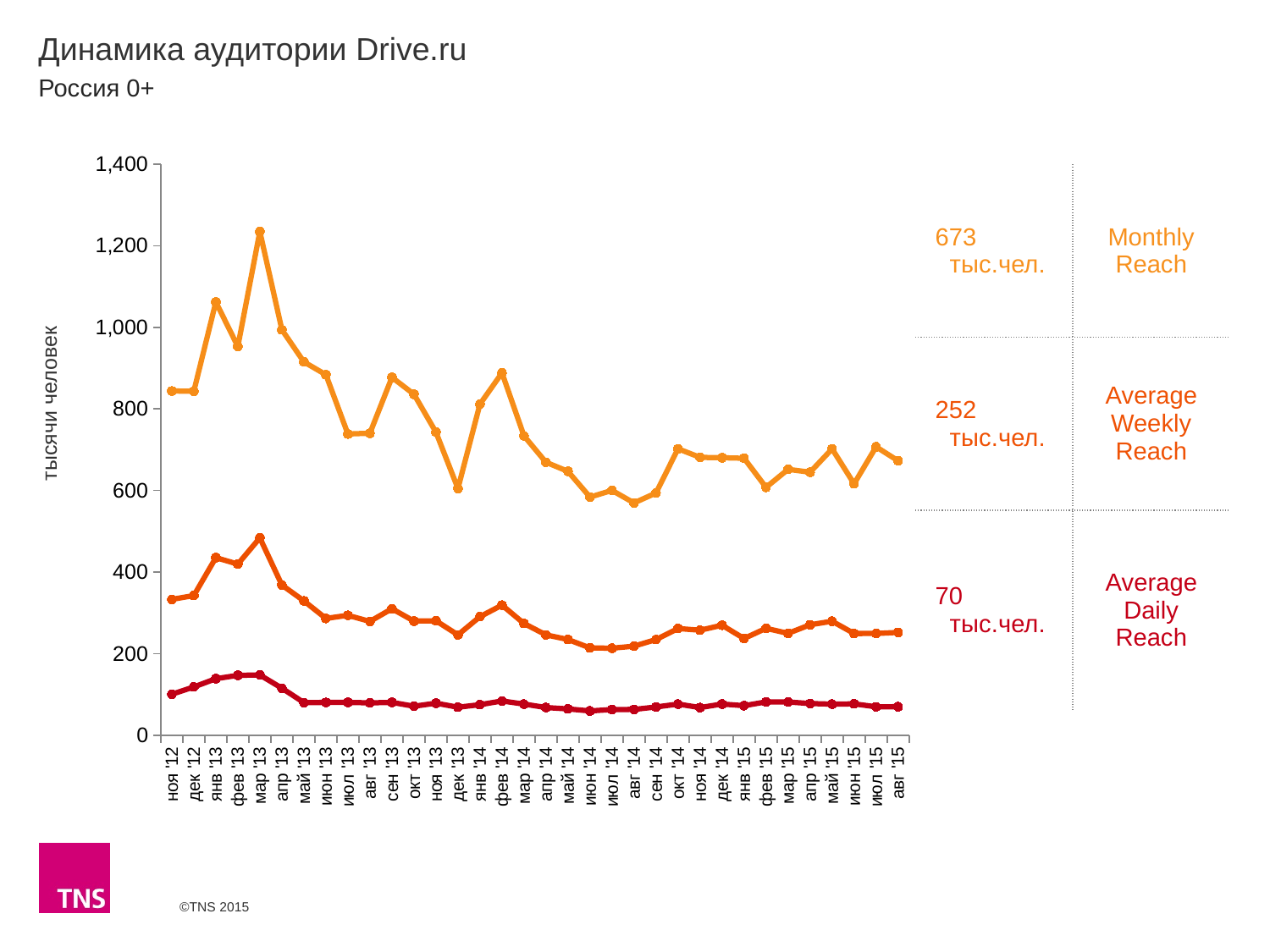
What is the Average Weekly Reach value shown for the latest month (авг '15)? 252 тыс.чел. Which is larger: the Monthly Reach in мар '13 or in фев '14? мар '13 Is the Monthly Reach value for мар '13 greater or less than 1,200? greater What is the Monthly Reach value shown for the latest month (авг '15)? 673 тыс.чел. What is the label on the vertical axis of the chart? тысячи человек In which month does the Monthly Reach line reach its highest point? мар '13 What is the difference between the Monthly Reach (673 тыс.чел.) and the Average Weekly Reach (252 тыс.чел.) shown for авг '15? 421 тыс.чел. How many series are plotted on the chart? 3 How many monthly points are plotted along the x axis, from ноя '12 to авг '15? 34 What type of chart is shown on the slide? line chart What is the Average Daily Reach value shown for the latest month (авг '15)? 70 тыс.чел. Is the Monthly Reach value for дек '13 greater or less than 800? less